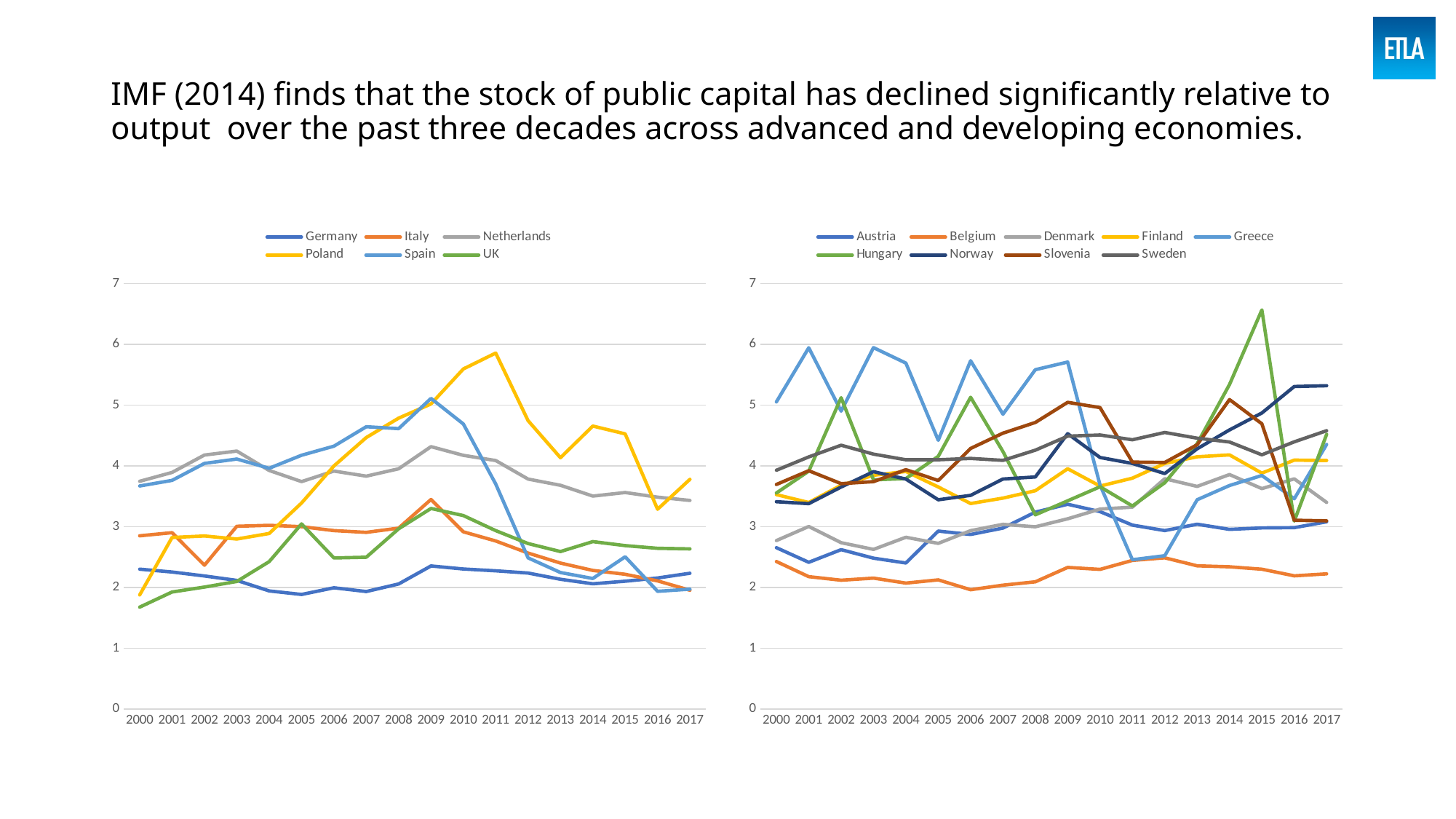
In the right-hand chart, which is larger in 2015, Hungary or Belgium? Hungary In the right-hand chart, which series has the lowest value in 2006? Belgium In the right-hand chart, is the value for Norway in 2017 greater or less than 5? greater What kind of chart is the chart on the left side of the slide? line chart How many years are shown on the x axis of the left-hand chart? 18 How many series does the legend of the right-hand chart list? 9 In the right-hand chart, which series reaches the highest value in 2015? Hungary How many series does the legend of the left-hand chart list? 6 In the left-hand chart, is the value for UK in 2000 greater or less than 2? less In the left-hand chart, is the value for Poland in 2011 greater or less than 5? greater In the left-hand chart, which series reaches the highest value in 2011? Poland In the left-hand chart, does the Poland line overall rise or fall from 2000 to 2017? rise